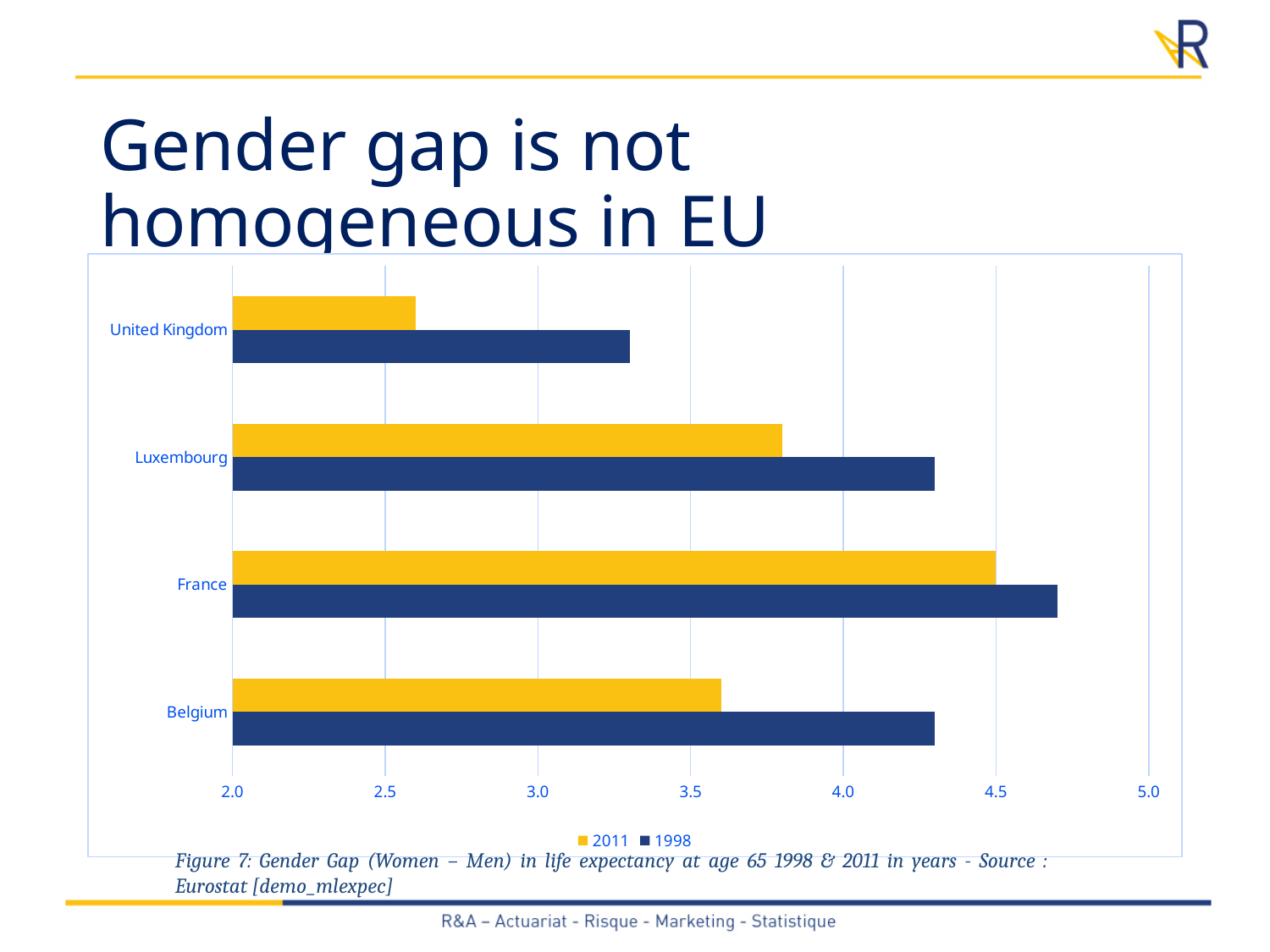
Which country has the lowest value for 2011? United Kingdom Which is larger, the 2011 value for France or the 2011 value for Luxembourg? France Is the value for France in 1998 greater or less than 4.5? greater How many countries are shown on the chart? 4 How many series does the legend list? 2 Is the value for Luxembourg in 2011 greater or less than 4.0? less Is the value for Belgium in 1998 greater or less than 4.0? greater Which country has the highest value for 1998? France Which colour represents the 2011 series in the legend? yellow What kind of chart is shown on the slide? bar chart